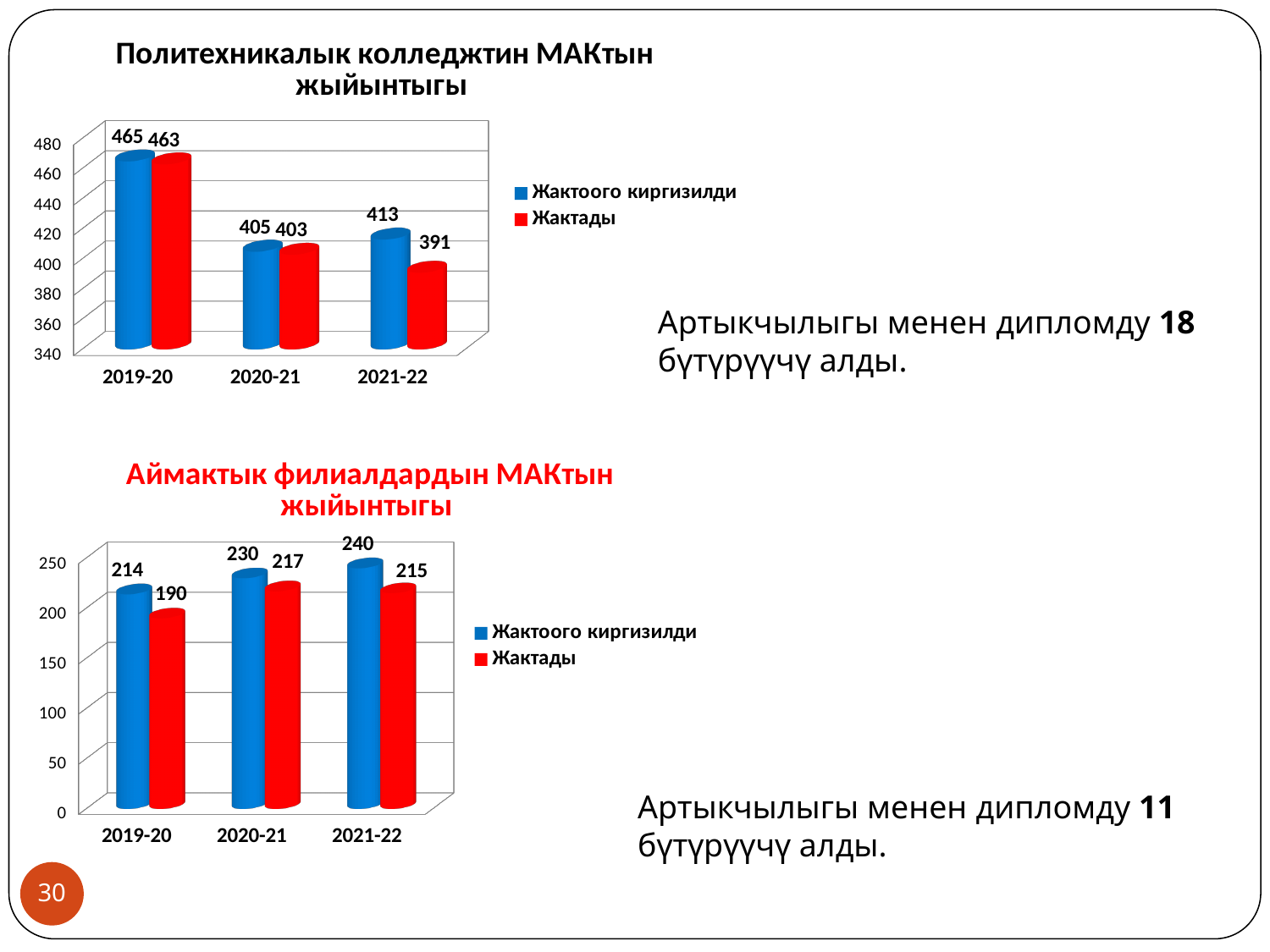
What kind of chart is the bottom chart (Аймактык филиалдардын МАКтын жыйынтыгы)? bar chart In the top chart (Политехникалык колледжтин МАКтын жыйынтыгы), what is the difference between Жактоого киргизилди and Жактады for 2021-22? 22 In the bottom chart (Аймактык филиалдардын МАКтын жыйынтыгы), what is the value of Жактады for 2019-20? 190 In the top chart (Политехникалык колледжтин МАКтын жыйынтыгы), which year has the lowest value for Жактады? 2021-22 In the top chart (Политехникалык колледжтин МАКтын жыйынтыгы), what is the value of Жактады for 2021-22? 391 In the top chart (Политехникалык колледжтин МАКтын жыйынтыгы), how many series does the legend list? 2 In the top chart (Политехникалык колледжтин МАКтын жыйынтыгы), what is the value of Жактоого киргизилди for 2019-20? 465 In the bottom chart (Аймактык филиалдардын МАКтын жыйынтыгы), which year has the highest value for Жактоого киргизилди? 2021-22 In the top chart (Политехникалык колледжтин МАКтын жыйынтыгы), which colour represents the Жактады series? red In the bottom chart (Аймактык филиалдардын МАКтын жыйынтыгы), how many year categories are shown on the x axis? 3 In the bottom chart (Аймактык филиалдардын МАКтын жыйынтыгы), what is the difference between Жактоого киргизилди and Жактады for 2020-21? 13 In the bottom chart (Аймактык филиалдардын МАКтын жыйынтыгы), does Жактоого киргизилди rise or fall from 2019-20 to 2021-22? rise